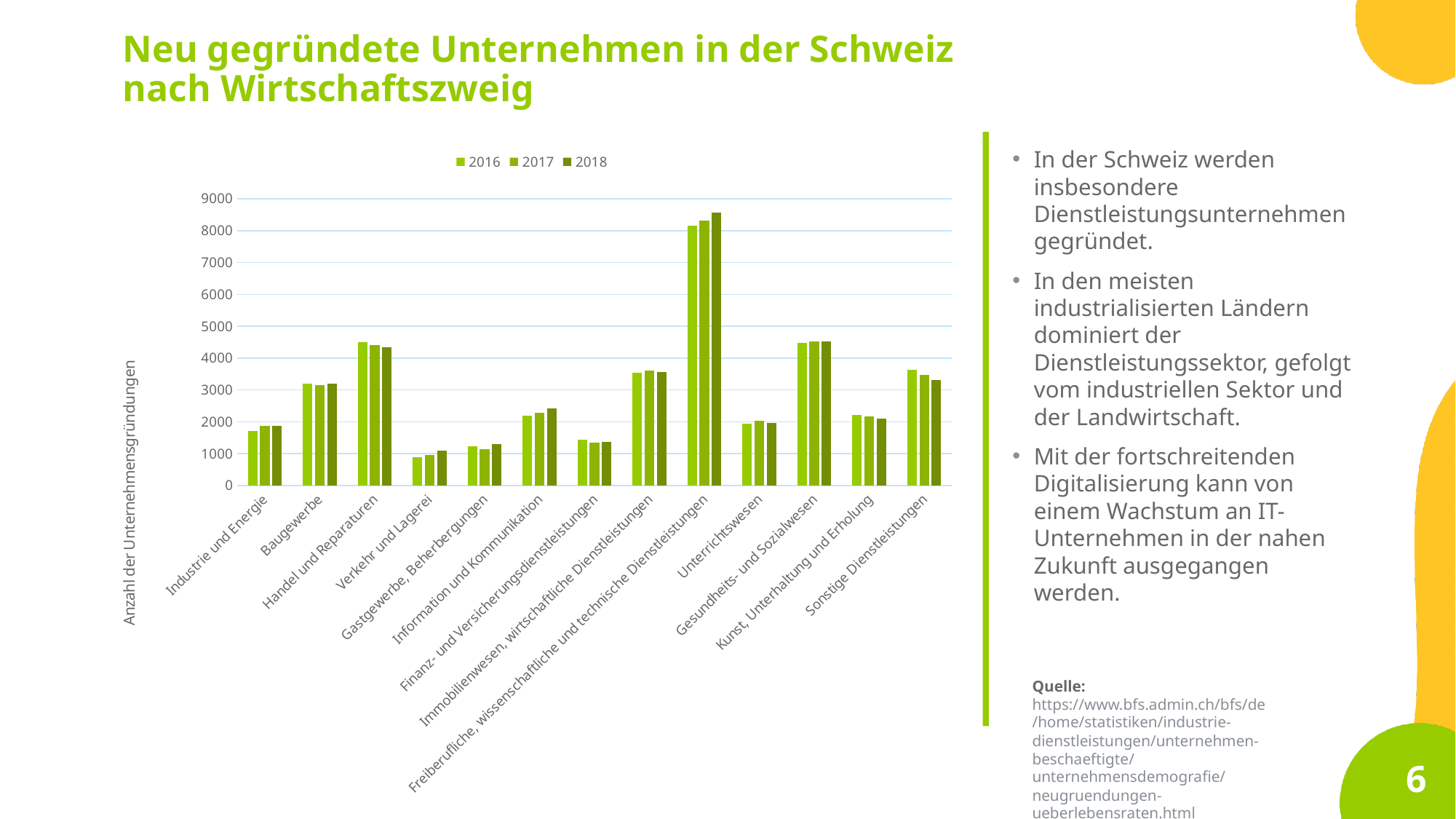
Is the 2016 value for Verkehr und Lagerei greater or less than 1000? less How many series does the legend list? 3 How many categories (Wirtschaftszweige) are shown on the x axis? 13 What kind of chart is shown on the slide? bar chart Is the 2016 value for Baugewerbe greater or less than 3000? greater Do the values for Freiberufliche, wissenschaftliche und technische Dienstleistungen rise or fall from 2016 to 2018? rise Which is larger in 2016: Handel und Reparaturen or Baugewerbe? Handel und Reparaturen Which category has the highest number of Unternehmensgründungen? Freiberufliche, wissenschaftliche und technische Dienstleistungen Which category has the lowest number of Unternehmensgründungen? Verkehr und Lagerei What is the label of the y axis? Anzahl der Unternehmensgründungen Is the 2018 value for Freiberufliche, wissenschaftliche und technische Dienstleistungen greater or less than 8000? greater